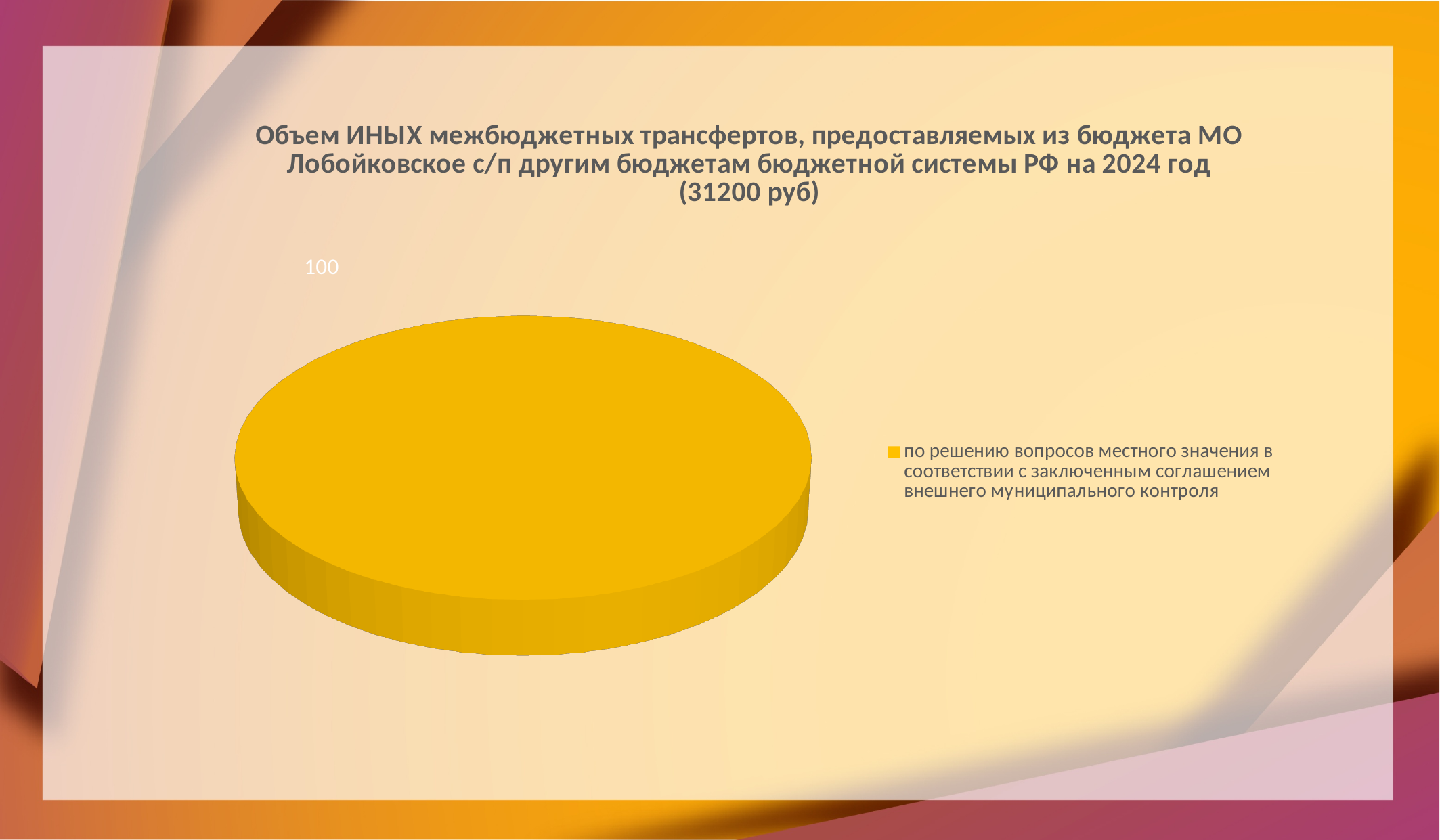
What colour is the single slice of the pie chart? yellow How many entries does the legend of the pie chart list? 1 What is the value for the category 'по решению вопросов местного значения в соответствии с заключенным соглашением внешнего муниципального контроля'? 100 How many slices does the pie chart have? 1 What kind of chart is shown on the slide? pie chart What value is printed as the data label on the pie chart? 100 What share of the pie does the slice 'по решению вопросов местного значения в соответствии с заключенным соглашением внешнего муниципального контроля' represent? 100 What total amount in rubles is stated in the chart title? 31200 руб